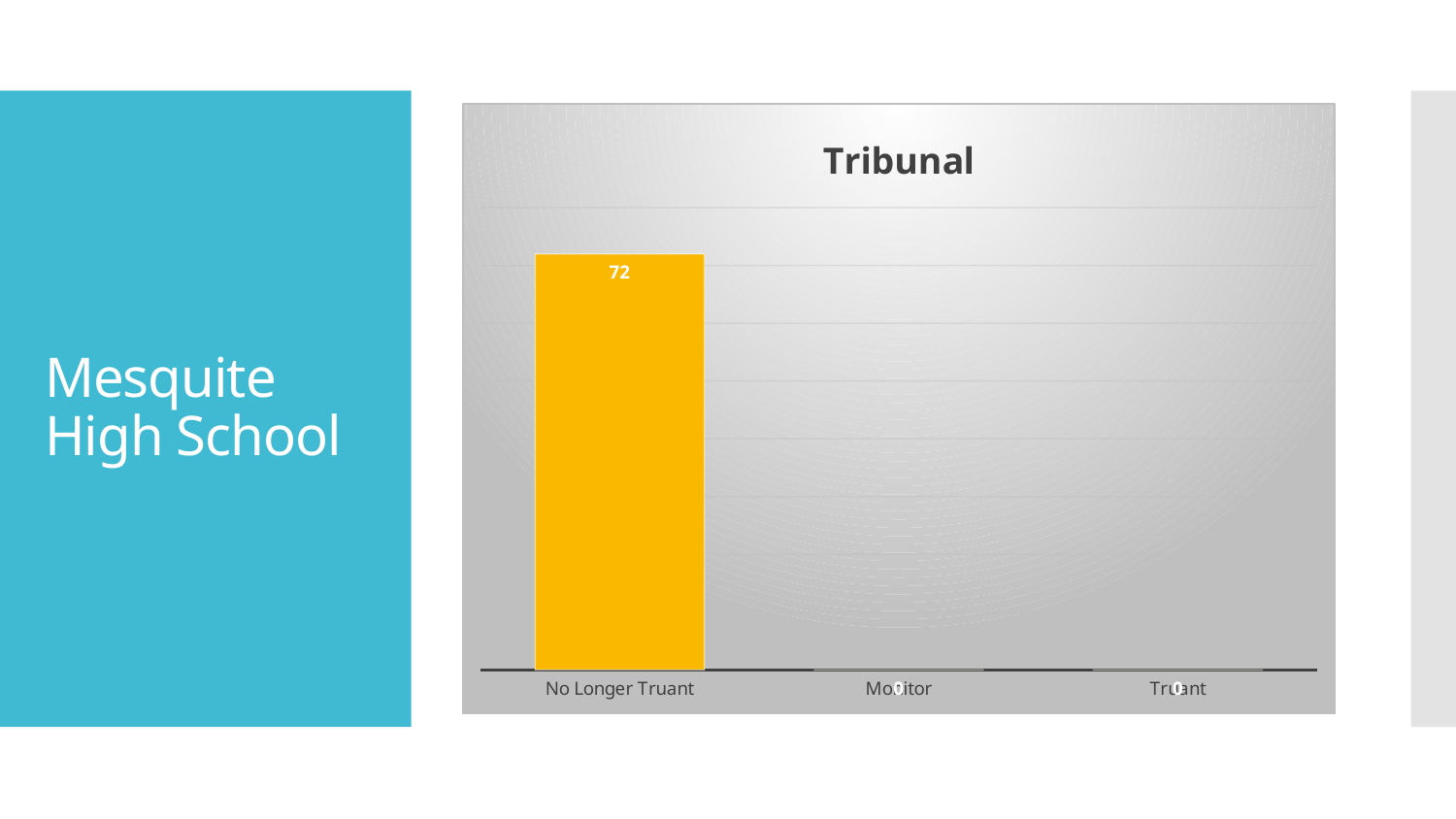
What is the value for Monitor? 0 How many categories are shown on the x axis? 3 Which category has the highest value? No Longer Truant Which is larger, the value for No Longer Truant or the value for Monitor? No Longer Truant What is the value for Truant? 0 What colour is the bar for No Longer Truant? Yellow What is the difference between the values for No Longer Truant and Truant? 72 What is the total of the values for all three categories? 72 What kind of chart is shown? Bar chart What is the value for No Longer Truant? 72 What is the title of the chart? Tribunal